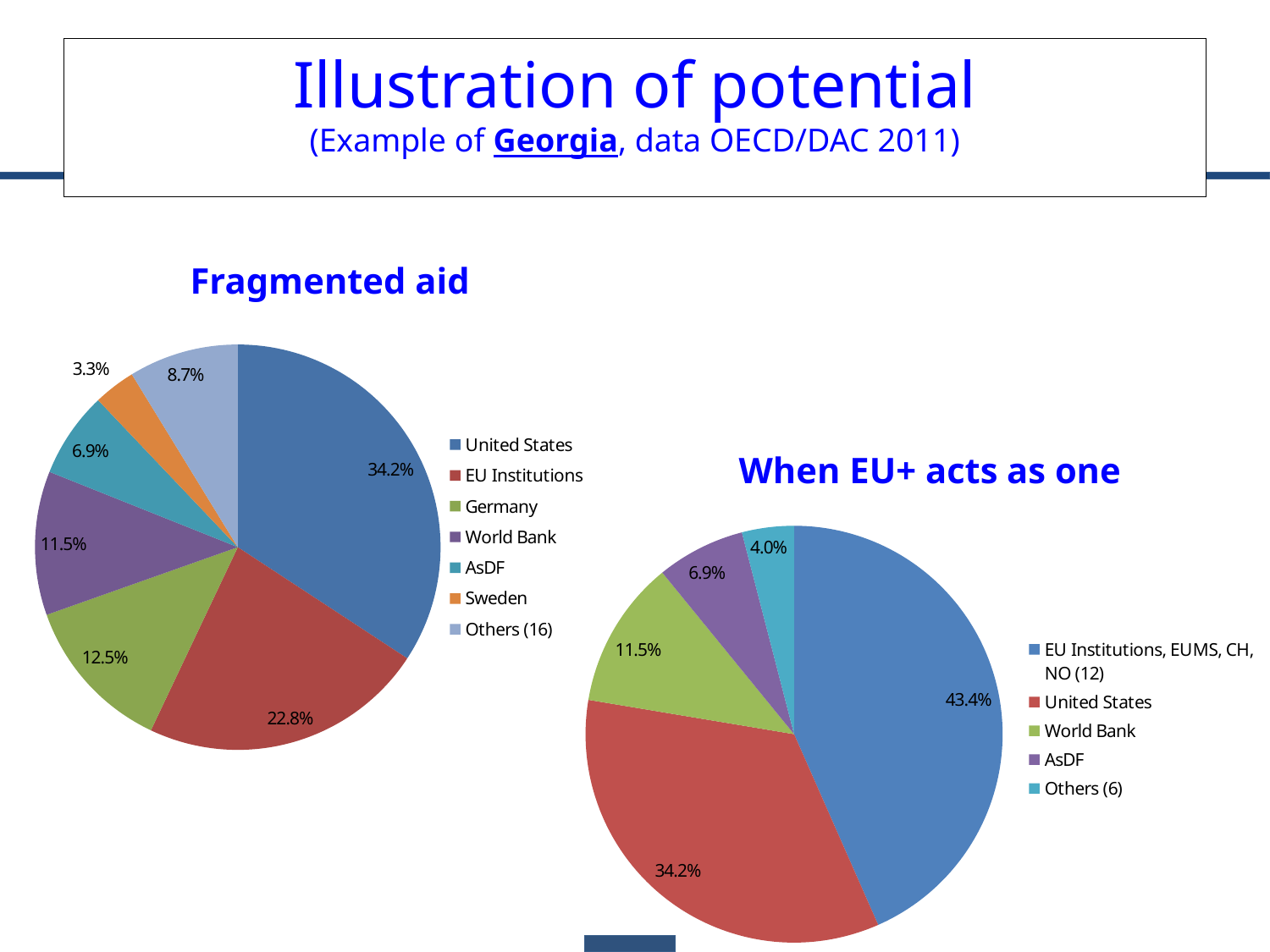
In the 'Fragmented aid' chart, how many slices does the pie have? 7 In the 'When EU+ acts as one' chart, how many entries does the legend list? 5 In the 'When EU+ acts as one' chart, what share does 'Others (6)' have? 4.0% In the 'Fragmented aid' chart, what share does the United States have? 34.2% In the 'When EU+ acts as one' chart, what is the difference between the EU Institutions, EUMS, CH, NO (12) share and the United States share? 9.2% In the 'Fragmented aid' chart, which category has the smallest share? Sweden What type of chart is the 'Fragmented aid' chart? Pie chart In the 'When EU+ acts as one' chart, what share does 'EU Institutions, EUMS, CH, NO (12)' have? 43.4% In the 'When EU+ acts as one' chart, which category has the largest share? EU Institutions, EUMS, CH, NO (12) In the 'Fragmented aid' chart, what is the difference between the United States share and the EU Institutions share? 11.4% In the 'When EU+ acts as one' chart, which is larger: the World Bank share or the AsDF share? World Bank In the 'Fragmented aid' chart, what share does Germany have? 12.5%